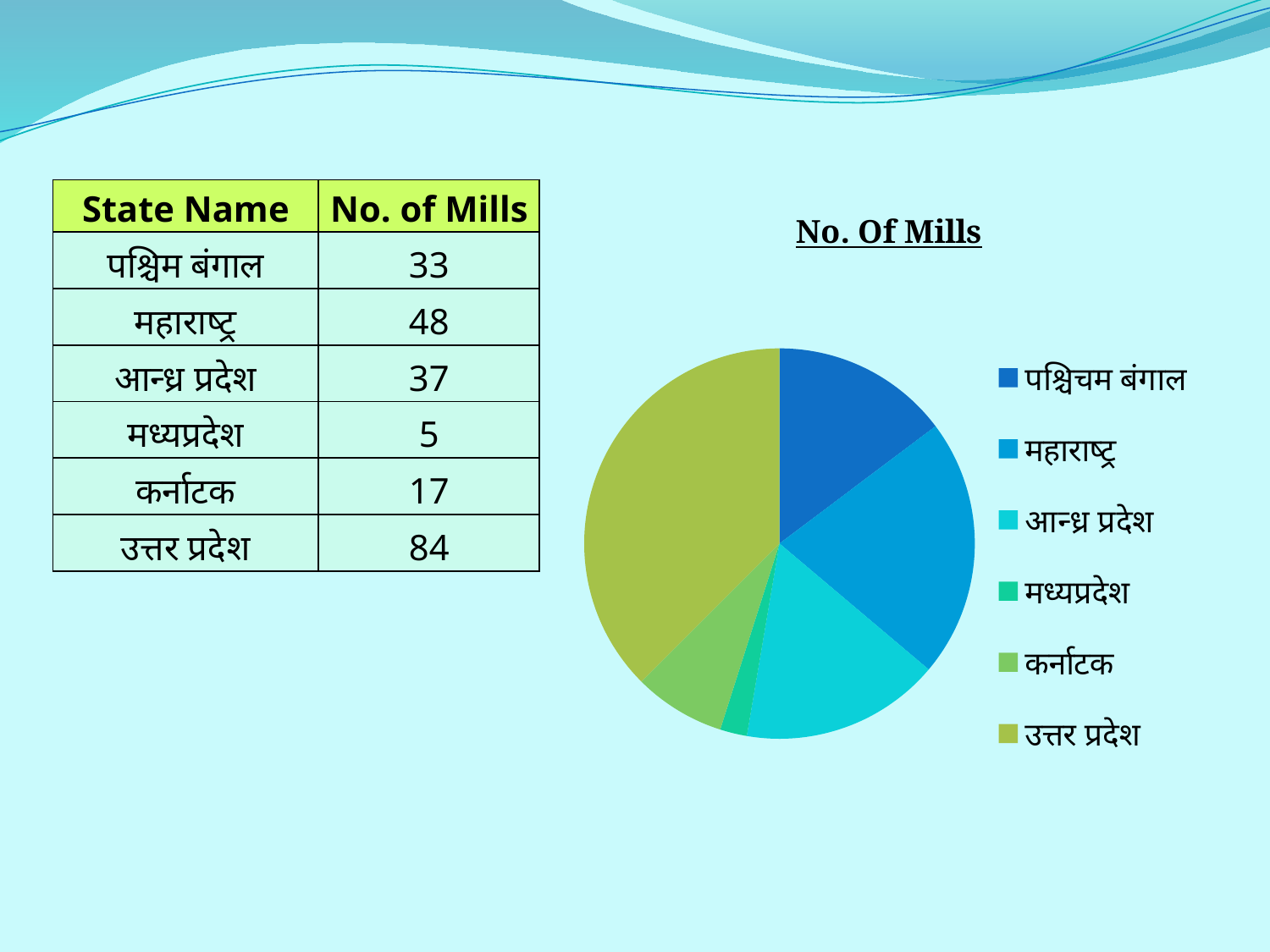
Which state has the smallest slice in the pie chart? मध्यप्रदेश How many more mills does उत्तर प्रदेश have than महाराष्ट्र? 36 What is the title of the pie chart? No. Of Mills Which has more mills, महाराष्ट्र or आन्ध्र प्रदेश? महाराष्ट्र How many states (slices) does the pie chart show? 6 What is the number of mills for उत्तर प्रदेश? 84 What is the difference in the number of mills between पश्चिम बंगाल and कर्नाटक? 16 What is the number of mills for कर्नाटक? 17 What share of the total number of mills does उत्तर प्रदेश account for? 37.5% Which state has the largest slice in the pie chart? उत्तर प्रदेश What is the number of mills for महाराष्ट्र? 48 What kind of chart is shown on the slide? pie chart